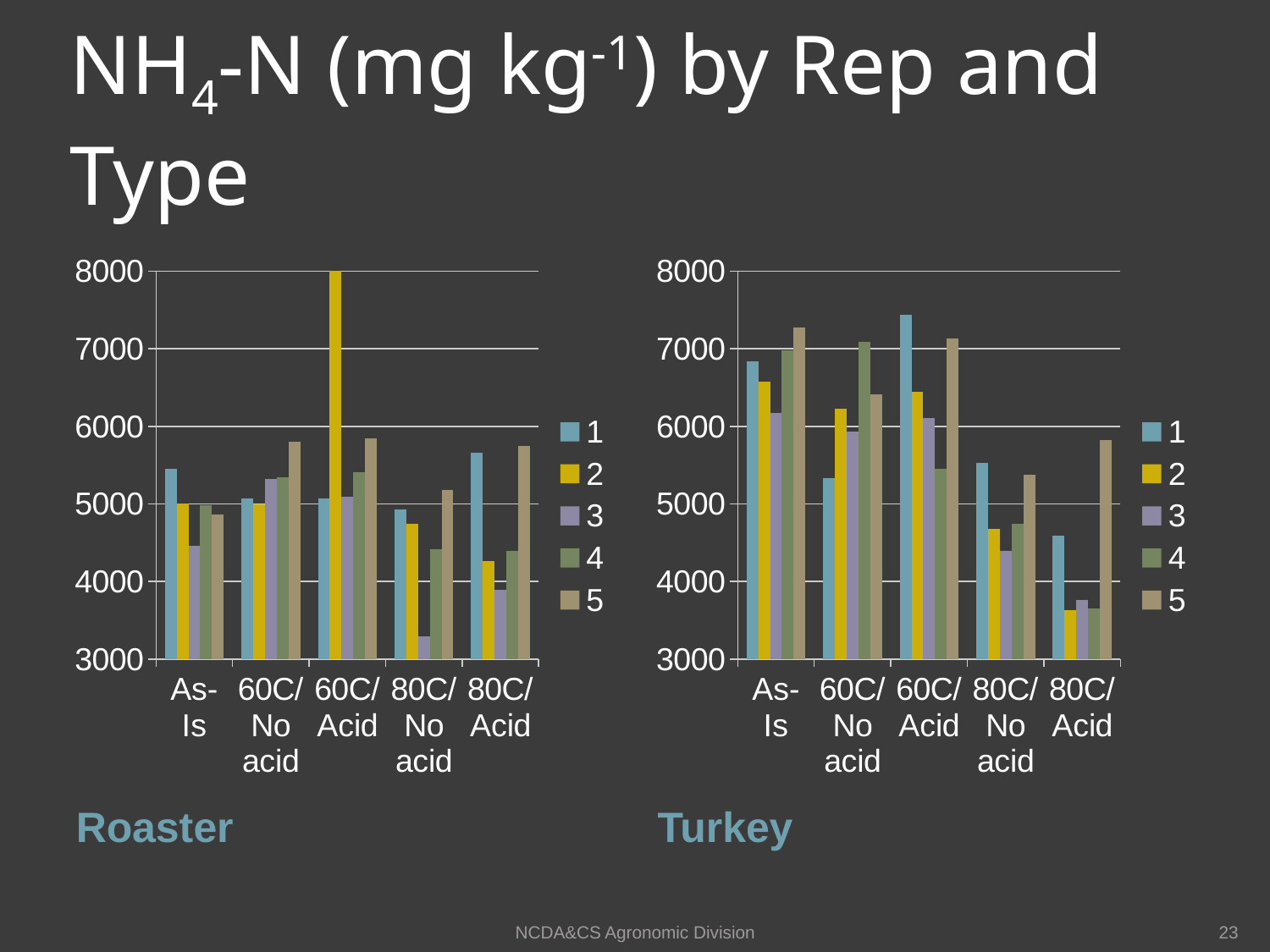
In the Turkey chart, is the value for series 5 at 80C/Acid greater or less than 6000? less What kind of chart is the Roaster chart? bar chart How many categories are shown on the x axis of the Turkey chart? 5 In the Roaster chart, is the value for series 1 at As-Is greater or less than 5000? greater In the Turkey chart, is the value for series 1 at 60C/No acid greater or less than 5000? greater What is the highest value shown on the y axis of the Turkey chart? 8000 How many series does the legend of the Roaster chart list? 5 In the Roaster chart, which category and series has the lowest bar? 80C/No acid, series 3 In the Roaster chart, which category and series has the highest bar? 60C/Acid, series 2 For series 1 at As-Is, which chart shows the larger value, Roaster or Turkey? Turkey In the Turkey chart, which is larger for series 1: the value at 80C/No acid or at 80C/Acid? 80C/No acid